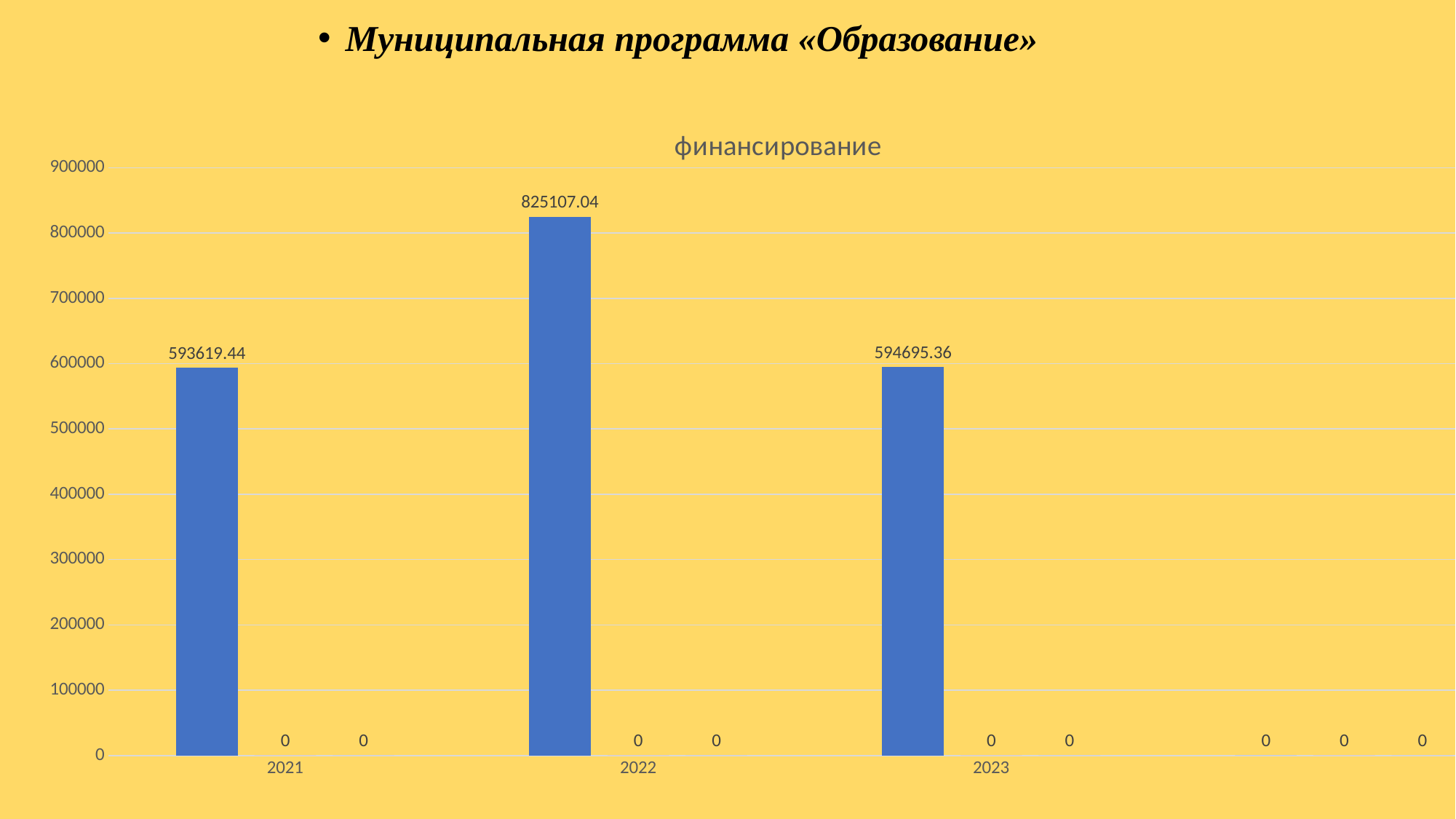
Which year has the highest value in the финансирование chart? 2022 What is the difference between the 2023 and 2021 values in the финансирование chart? 1075.92 What is the difference between the 2022 and 2021 values in the финансирование chart? 231487.60 How many years are labeled on the x axis of the финансирование chart? 3 What is the value for 2021 in the финансирование chart? 593619.44 What is the value for 2022 in the финансирование chart? 825107.04 Which year has the lowest non-zero value in the финансирование chart? 2021 What kind of chart is shown on the slide? bar chart What is the title of the chart on the slide? финансирование What is the value for 2023 in the финансирование chart? 594695.36 Which is larger in the финансирование chart, the value for 2021 or the value for 2023? 2023 Is the value for 2022 in the финансирование chart greater or less than 800000? greater